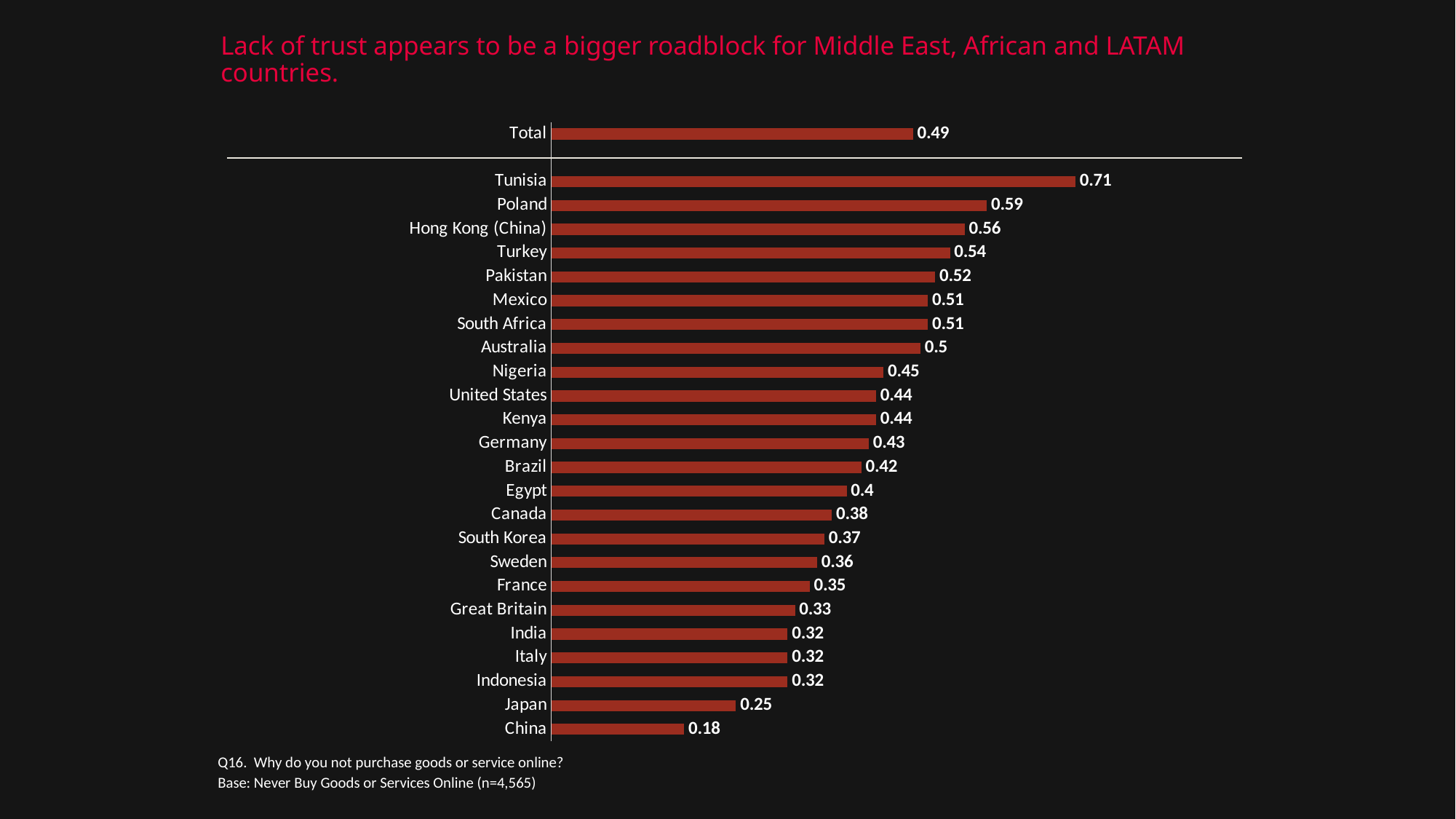
What is the value for the Total bar? 0.49 What kind of chart is shown on the slide? Bar chart What is the difference between the values for Tunisia and China? 0.53 Which has a larger value, Pakistan or Nigeria? Pakistan What is the difference between the values for Poland and Germany? 0.16 Which has a larger value, Egypt or Canada? Egypt What is the value for Hong Kong (China)? 0.56 What is the value for Japan? 0.25 What is the value for Tunisia? 0.71 How many countries are listed below the Total bar? 24 Which country has the highest value? Tunisia Which country has the lowest value? China